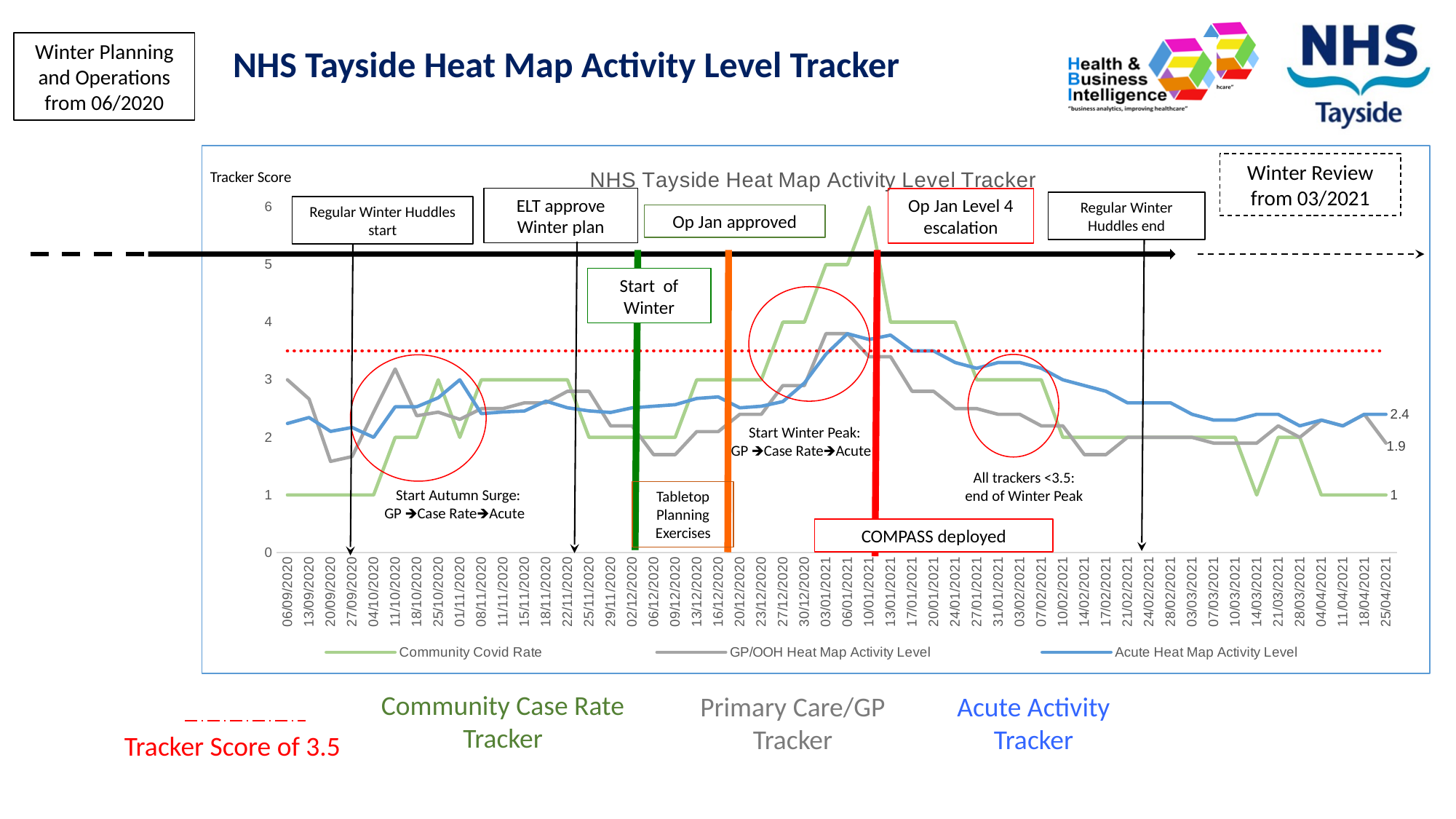
Is the peak value of the Community Covid Rate greater or less than 5? greater At 25/04/2021, which is higher: the Acute Heat Map Activity Level or the GP/OOH Heat Map Activity Level? Acute Heat Map Activity Level What is the value of the Community Covid Rate at the last date, 25/04/2021? 1 What is the label on the vertical axis of the chart? Tracker Score What is the value of the Acute Heat Map Activity Level at the last date, 25/04/2021? 2.4 What Tracker Score does the red dotted horizontal line on the chart represent? 3.5 Does the Community Covid Rate rise or fall between its peak in January 2021 and 25/04/2021? fall Which series reaches the highest value anywhere on the chart? Community Covid Rate How many series does the chart legend list? 3 What is the difference between the Acute Heat Map Activity Level and the GP/OOH Heat Map Activity Level at 25/04/2021? 0.5 What is the value of the GP/OOH Heat Map Activity Level at the last date, 25/04/2021? 1.9 What type of chart is shown on the slide? line chart